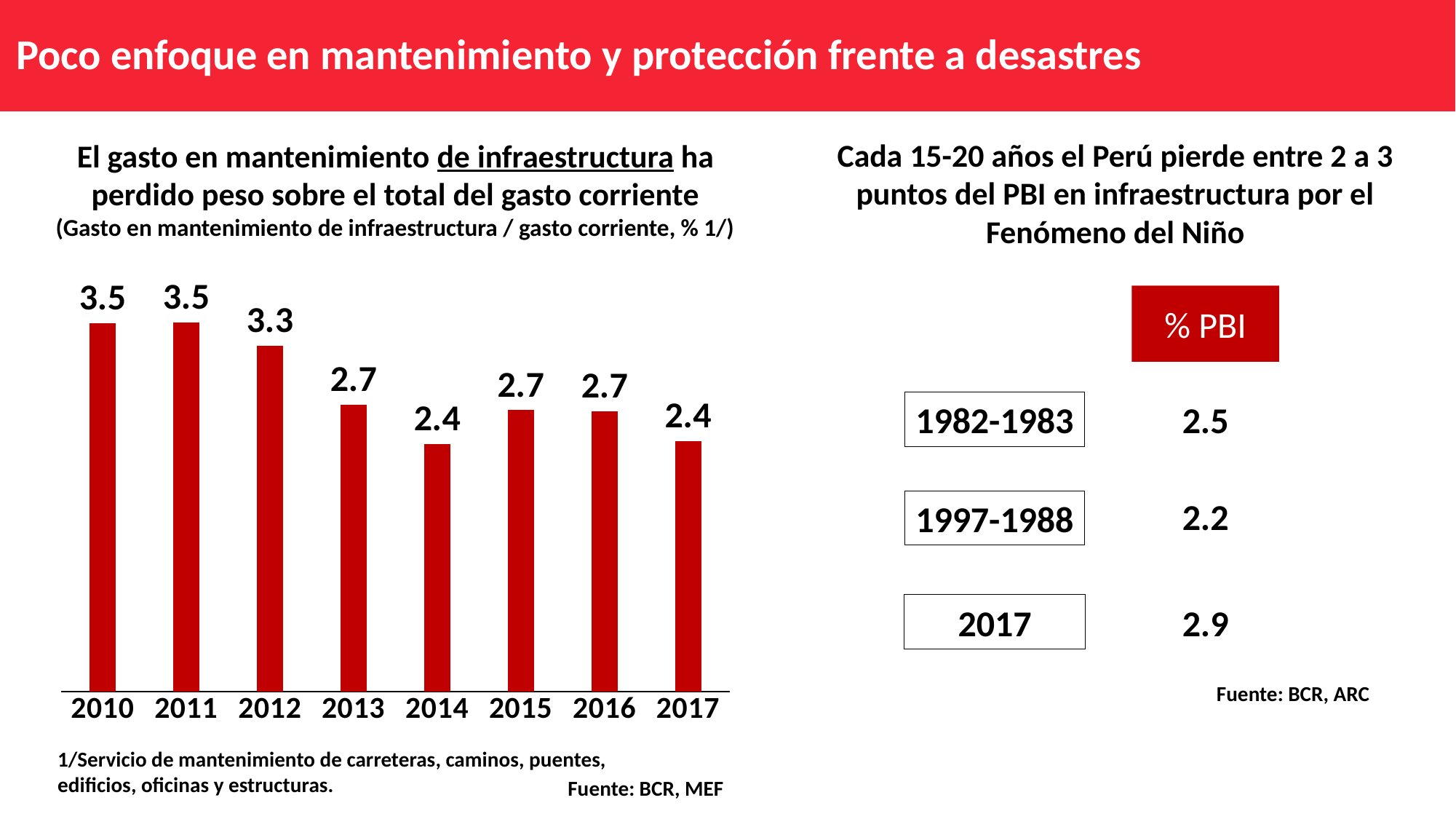
What is the value for 2010 in the bar chart? 3.5 What is the value for 2016 in the bar chart? 2.7 What kind of chart is shown on the left of the slide? Bar chart What is the difference between the values for 2010 and 2017 in the bar chart? 1.1 Do the values in the bar chart generally rise or fall from 2010 to 2017? Fall What is the value for 2014 in the bar chart? 2.4 What is the highest value shown in the bar chart? 3.5 What is the lowest value shown in the bar chart? 2.4 What is the difference between the values for 2012 and 2013 in the bar chart? 0.6 Which year has the larger value in the bar chart, 2013 or 2014? 2013 How many years are shown in the bar chart? 8 What is the value for 2012 in the bar chart? 3.3